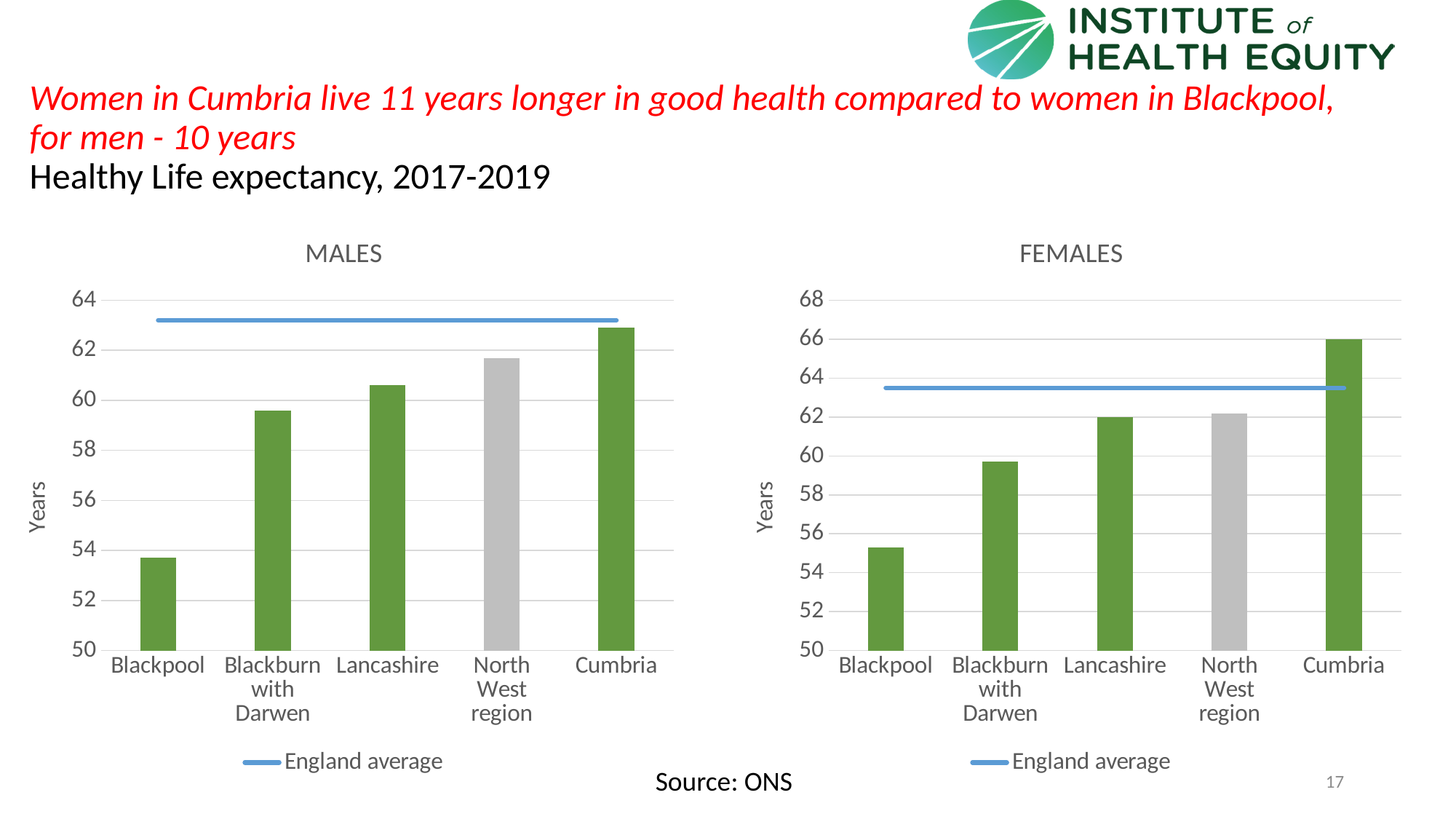
What type of chart is the MALES chart? bar chart In the MALES chart, which category has the lowest healthy life expectancy? Blackpool What does the blue horizontal line in the FEMALES chart represent, according to the legend? England average In the FEMALES chart, which category has the lowest healthy life expectancy? Blackpool In the FEMALES chart, which is larger, the value for Blackburn with Darwen or the value for Lancashire? Lancashire How many categories are shown on the x axis of the FEMALES chart? 5 In the MALES chart, which category has the highest healthy life expectancy? Cumbria In the FEMALES chart, is the value for Cumbria greater or less than 64? greater In the MALES chart, is the value for Blackpool greater or less than 54? less In the MALES chart, is the value for Lancashire greater or less than 60? greater In the FEMALES chart, which category has the highest healthy life expectancy? Cumbria In the MALES chart, do the bar values rise or fall from Blackpool to Cumbria along the x axis? rise